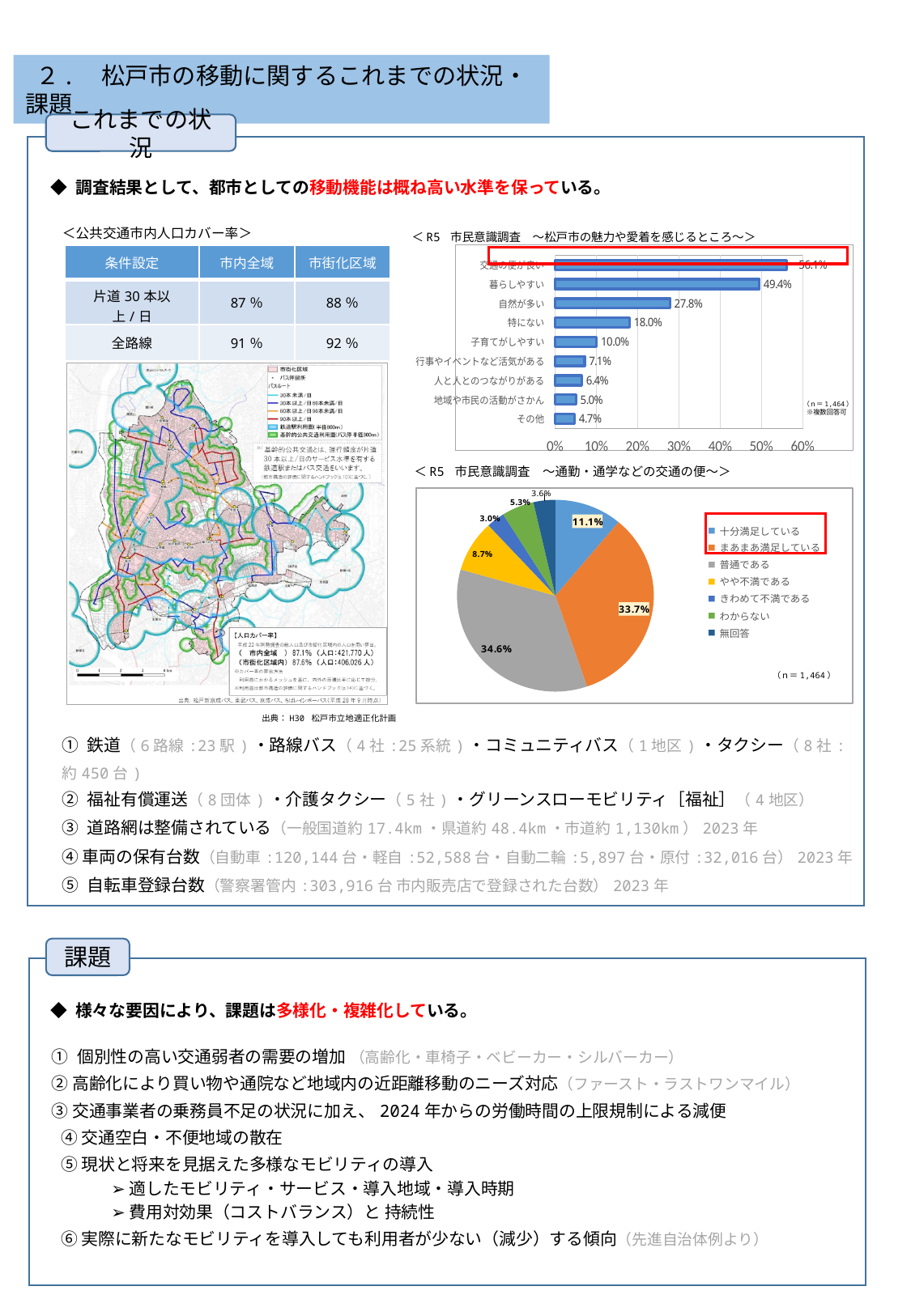
In the bar chart '市民意識調査 ～松戸市の魅力や愛着を感じるところ～', what is the value for 暮らしやすい? 49.4% How many entries does the legend of the pie chart '市民意識調査 ～通勤・通学などの交通の便～' list? 7 In the bar chart '市民意識調査 ～松戸市の魅力や愛着を感じるところ～', which category has the highest value? 交通の便が良い What kind of chart is '市民意識調査 ～通勤・通学などの交通の便～'? pie chart In the bar chart '市民意識調査 ～松戸市の魅力や愛着を感じるところ～', what is the value for 自然が多い? 27.8% In the pie chart '市民意識調査 ～通勤・通学などの交通の便～', which slice is the largest? 普通である In the pie chart '市民意識調査 ～通勤・通学などの交通の便～', which is larger: やや不満である or わからない? やや不満である In the pie chart '市民意識調査 ～通勤・通学などの交通の便～', what share is まあまあ満足している? 33.7% In the bar chart '市民意識調査 ～松戸市の魅力や愛着を感じるところ～', is the value for 特にない greater or less than 20%? less In the bar chart '市民意識調査 ～松戸市の魅力や愛着を感じるところ～', what is the difference between 暮らしやすい and 自然が多い? 21.6% In the bar chart '市民意識調査 ～松戸市の魅力や愛着を感じるところ～', which category has the lowest value? その他 In the bar chart '市民意識調査 ～松戸市の魅力や愛着を感じるところ～', how many categories are shown? 9